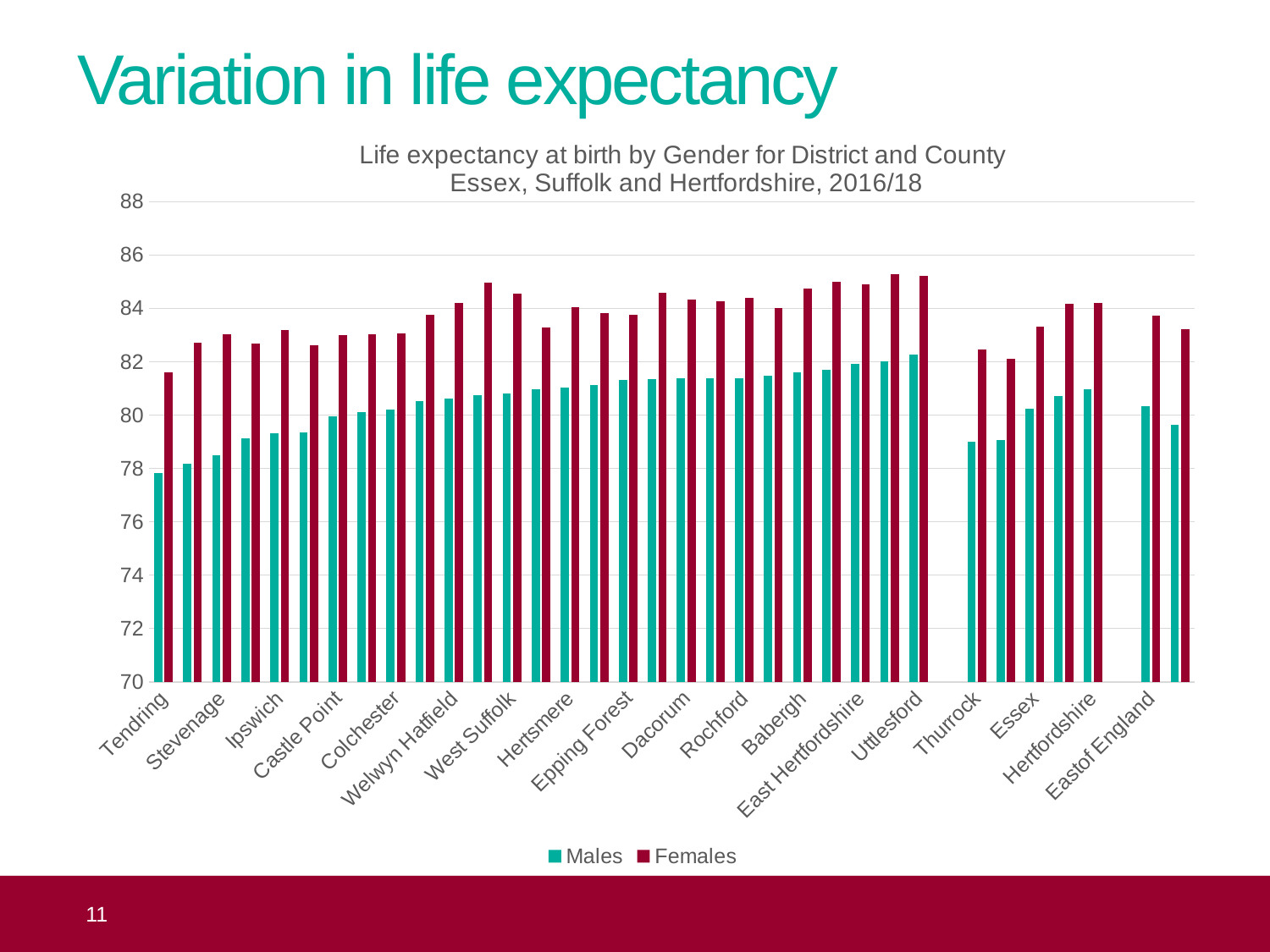
Which district has the lowest Males value? Tendring Is the Males value for Thurrock greater or less than 80? less How many series does the legend list? 2 What is the title of the chart? Life expectancy at birth by Gender for District and County Essex, Suffolk and Hertfordshire, 2016/18 What are the two series shown in the legend? Males and Females What kind of chart is shown on the slide? Bar chart Which is larger for Tendring, the Males value or the Females value? Females Is the Females value for Tendring greater or less than 80? greater Is the Males value for Tendring greater or less than 78? less Which has the larger Males value, Tendring or Uttlesford? Uttlesford